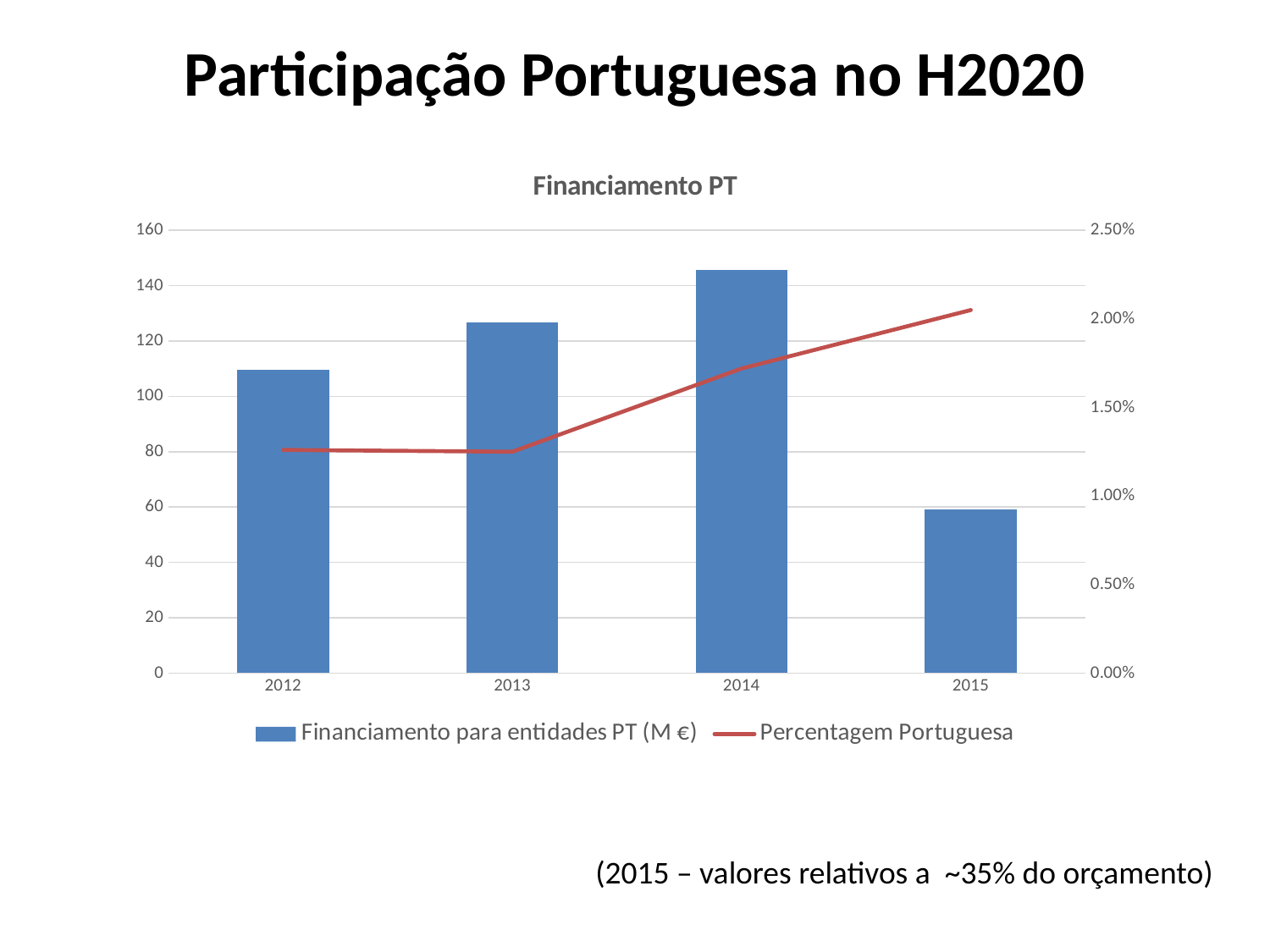
Is the value of Financiamento para entidades PT (M €) for 2014 greater or less than 140? greater What kind of chart is shown on the slide? A combined bar and line chart Is the Percentagem Portuguesa value for 2014 greater or less than 1.50%? greater How many series does the legend list? 2 How many years are shown on the x axis? 4 Which year has the lowest bar for Financiamento para entidades PT (M €)? 2015 What is the title of the chart? Financiamento PT Does the Percentagem Portuguesa line rise or fall from 2013 to 2015? rise Which year has the larger bar for Financiamento para entidades PT (M €), 2012 or 2013? 2013 Is the value of Financiamento para entidades PT (M €) for 2012 greater or less than 100? greater Which year has the highest bar for Financiamento para entidades PT (M €)? 2014